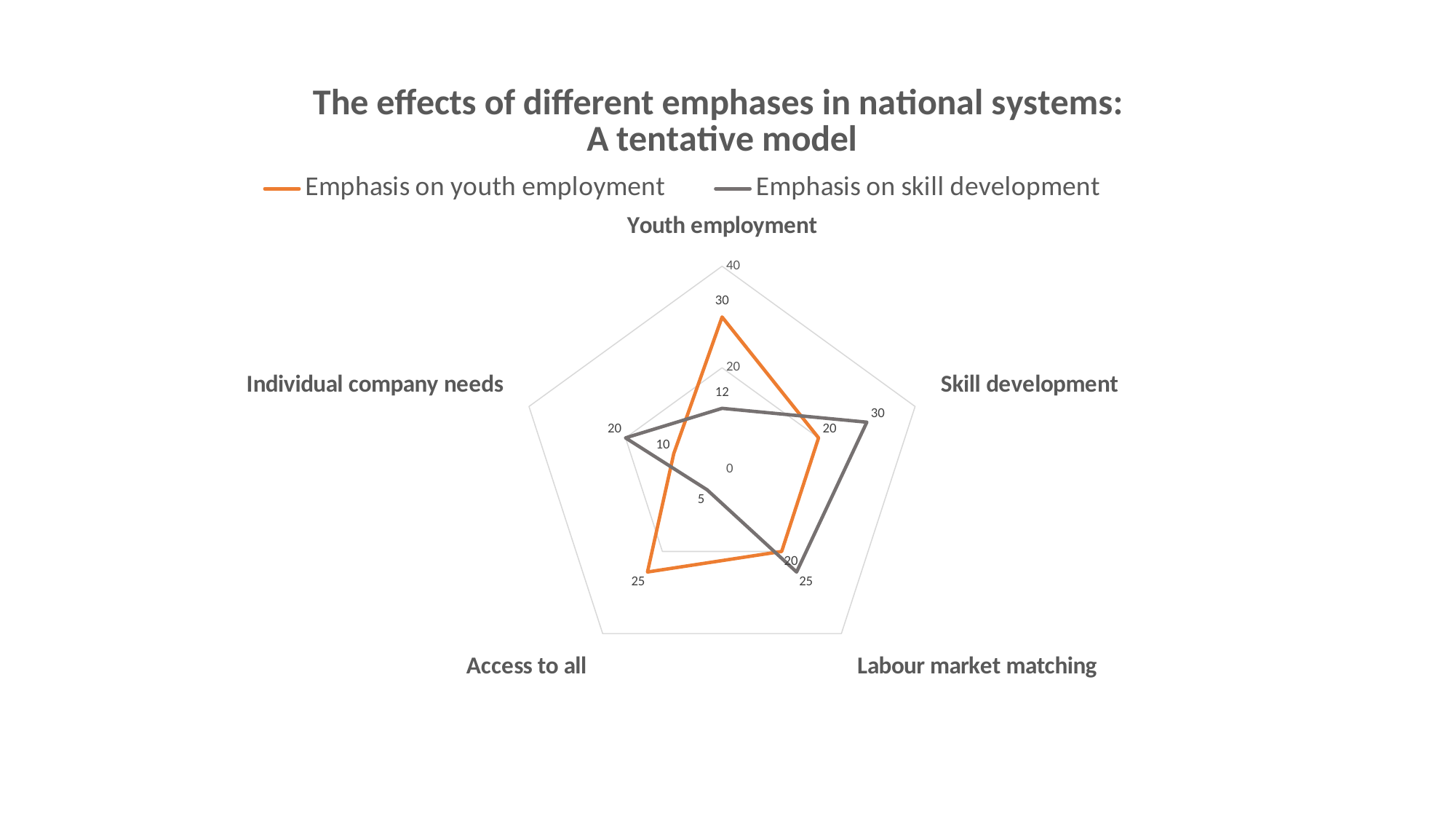
What is the difference between the two series' values for Access to all? 20 What is the value for Youth employment in the 'Emphasis on youth employment' series? 30 What is the value for Access to all in the 'Emphasis on skill development' series? 5 What kind of chart is shown on the slide? Radar chart Which category has the lowest value in the 'Emphasis on skill development' series? Access to all How many categories (axes) does the radar chart have? 5 What is the value for Youth employment in the 'Emphasis on skill development' series? 12 What is the value for Skill development in the 'Emphasis on skill development' series? 30 For Labour market matching, which series has the larger value? Emphasis on skill development Which category has the highest value in the 'Emphasis on youth employment' series? Youth employment How many series does the legend list? 2 What is the value for Individual company needs in the 'Emphasis on youth employment' series? 10